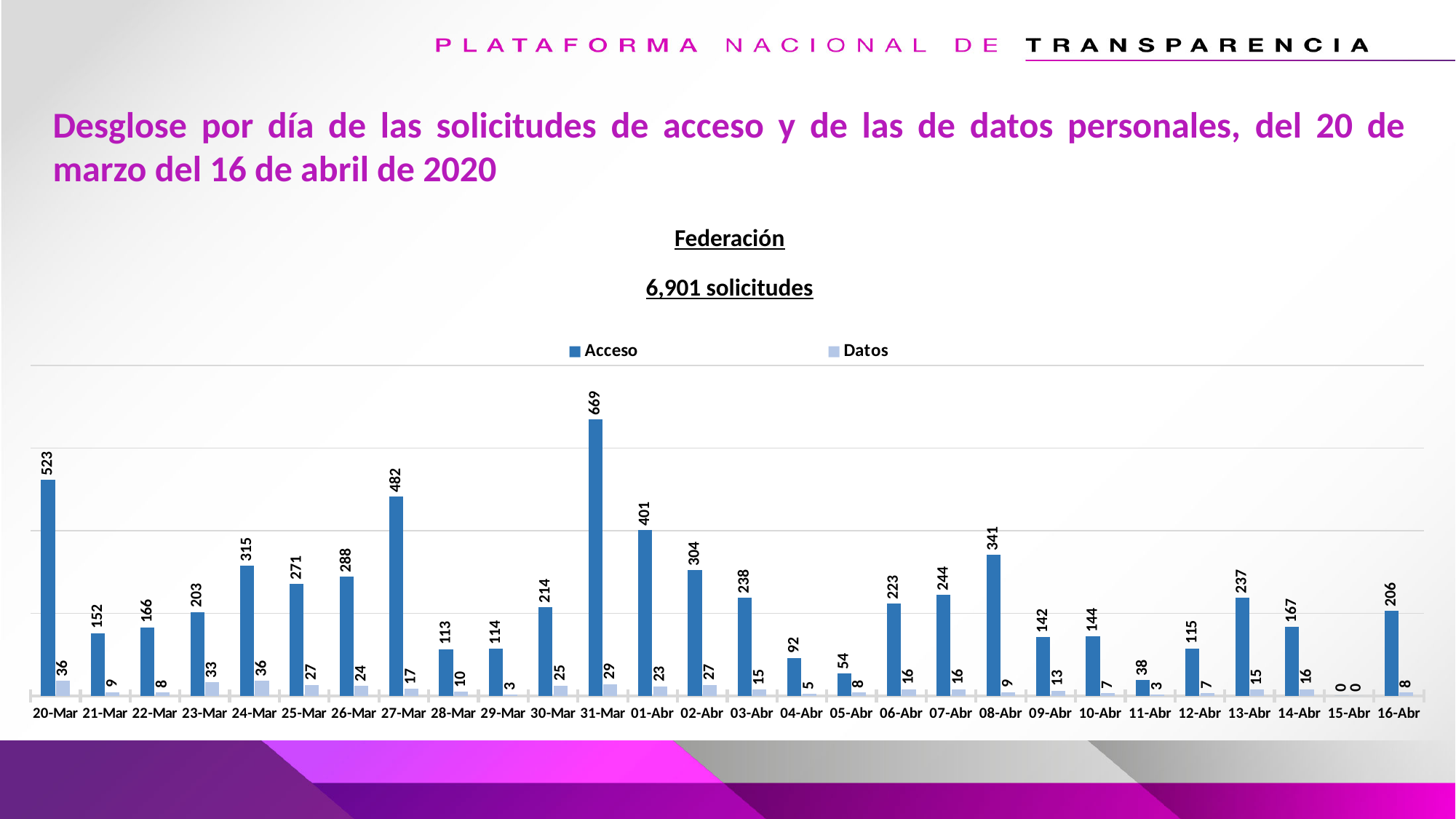
Which is larger, the Acceso value for 27-Mar or for 01-Abr? 27-Mar Which date has the lowest Acceso value? 15-Abr What is the total of Acceso and Datos for 08-Abr? 350 What is the title of the chart? Federación 6,901 solicitudes What kind of chart is shown? bar chart How many dates are shown on the x axis? 28 What is the Datos value for 20-Mar? 36 Which date has the highest Acceso value? 31-Mar What is the Acceso value for 16-Abr? 206 What is the Acceso value for 31-Mar? 669 What is the difference between the Acceso values for 20-Mar and 21-Mar? 371 How many series does the legend list? 2